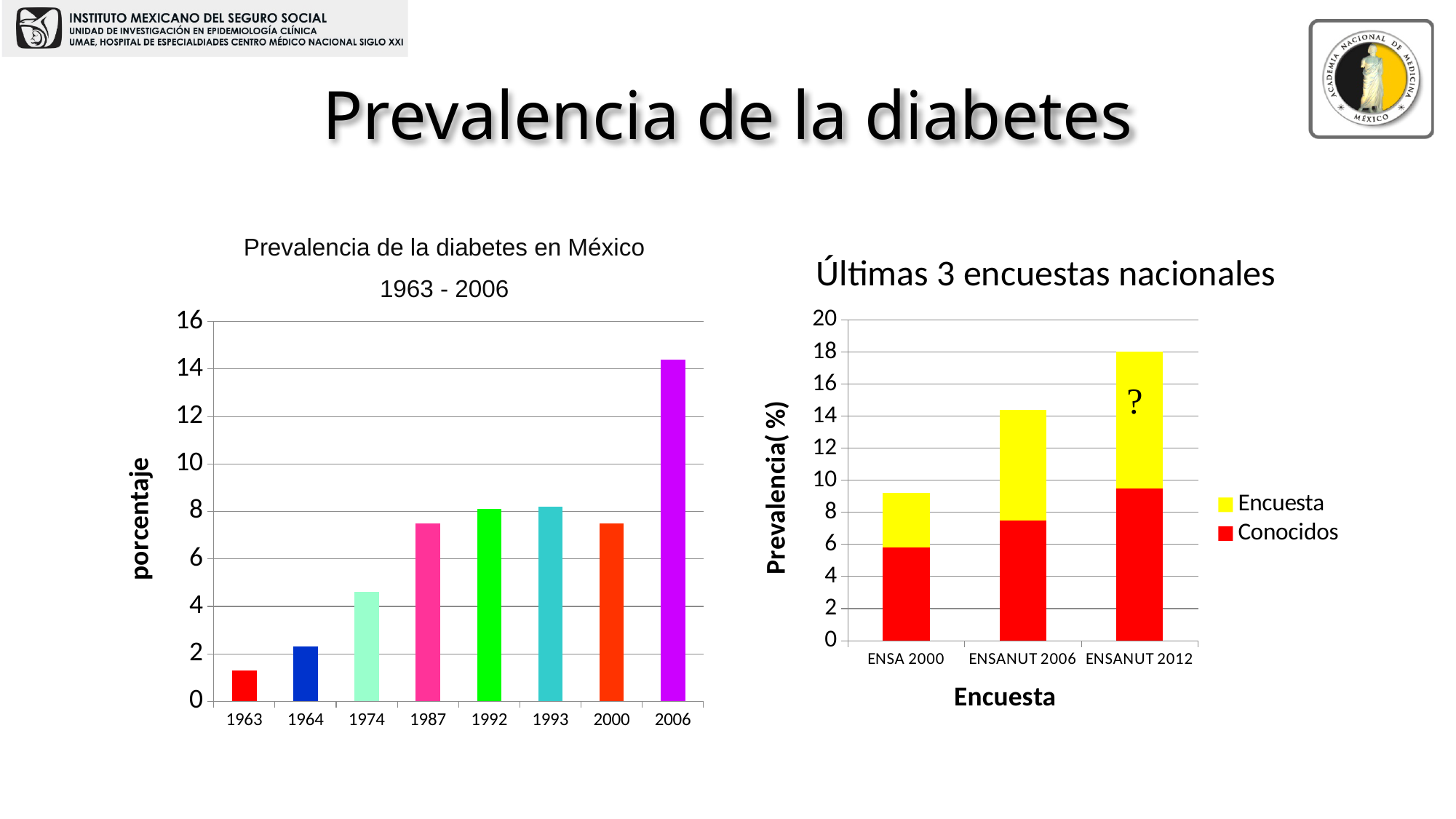
In the right chart 'Últimas 3 encuestas nacionales', is the Conocidos value for ENSANUT 2012 greater or less than 8? greater In the left chart 'Prevalencia de la diabetes en México 1963 - 2006', what is the label of the y axis? porcentaje In the left chart 'Prevalencia de la diabetes en México 1963 - 2006', which year has the lowest value? 1963 In the right chart 'Últimas 3 encuestas nacionales', do the total bar heights rise or fall from ENSA 2000 to ENSANUT 2012? rise In the left chart 'Prevalencia de la diabetes en México 1963 - 2006', which is larger, the value for 1974 or the value for 1987? 1987 In the left chart 'Prevalencia de la diabetes en México 1963 - 2006', is the value for 2006 greater or less than 12? greater In the right chart 'Últimas 3 encuestas nacionales', which survey has the tallest stacked bar? ENSANUT 2012 What type of chart is the left chart titled 'Prevalencia de la diabetes en México 1963 - 2006'? bar chart In the right chart 'Últimas 3 encuestas nacionales', how many series does the legend list? 2 In the left chart 'Prevalencia de la diabetes en México 1963 - 2006', which year has the highest value? 2006 In the left chart 'Prevalencia de la diabetes en México 1963 - 2006', is the value for 1974 greater or less than 6? less In the left chart 'Prevalencia de la diabetes en México 1963 - 2006', how many years are shown on the x axis? 8